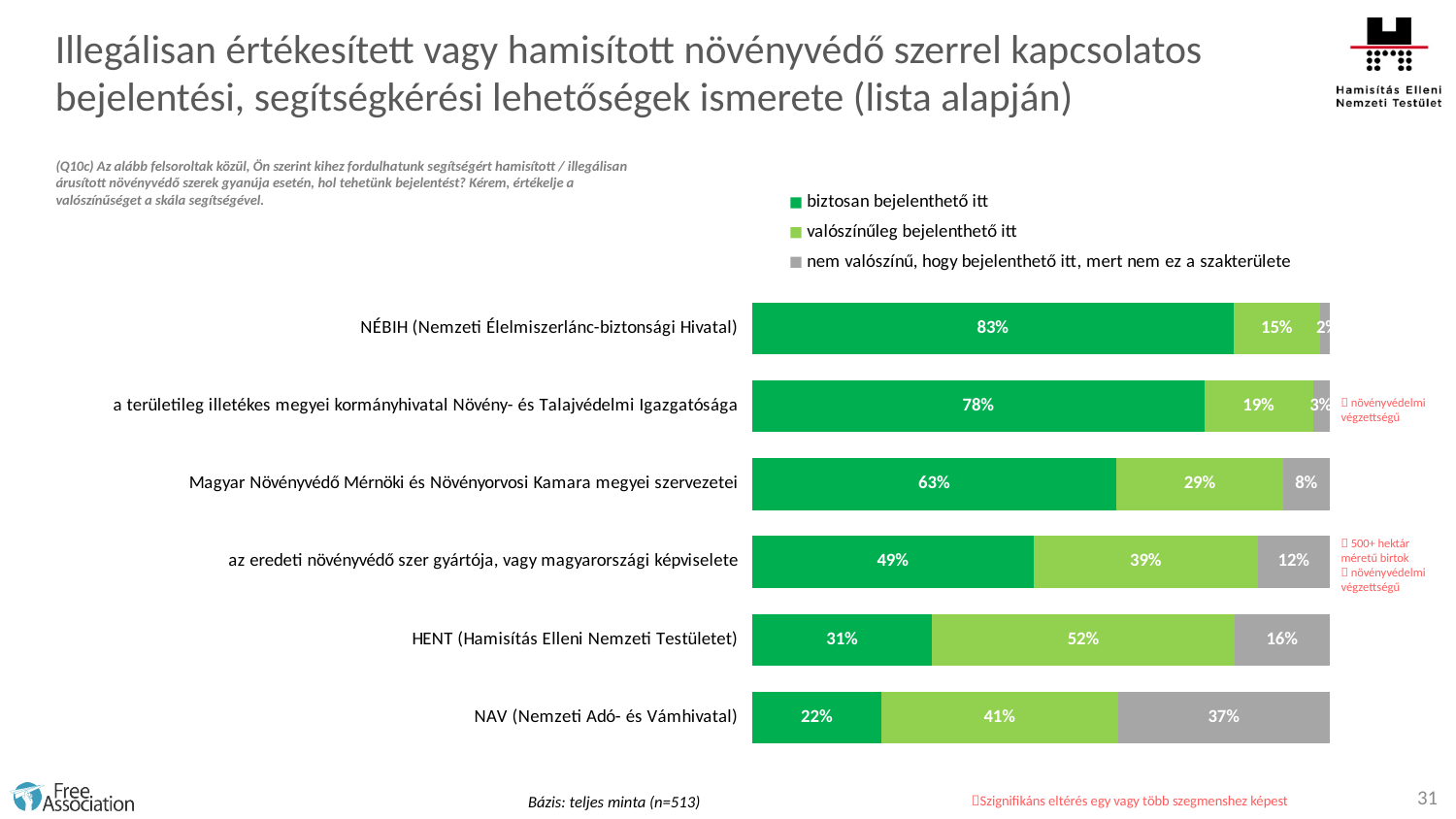
How many categories (organisations) are plotted in the chart? 6 Which is larger: the 'valószínűleg bejelenthető itt' value for the Magyar Növényvédő Mérnöki és Növényorvosi Kamara megyei szervezetei or for az eredeti növényvédő szer gyártója, vagy magyarországi képviselete? az eredeti növényvédő szer gyártója, vagy magyarországi képviselete Which organisation has the highest 'biztosan bejelenthető itt' share? NÉBIH (Nemzeti Élelmiszerlánc-biztonsági Hivatal) Do the 'biztosan bejelenthető itt' values rise or fall going down the list of organisations from top to bottom? fall How many series does the legend list? 3 What is the 'valószínűleg bejelenthető itt' value for HENT (Hamisítás Elleni Nemzeti Testületet)? 52% What is the 'nem valószínű, hogy bejelenthető itt, mert nem ez a szakterülete' value for NAV (Nemzeti Adó- és Vámhivatal)? 37% What is the difference between the 'biztosan bejelenthető itt' values for NÉBIH and HENT? 52 percentage points What is the 'biztosan bejelenthető itt' value for NÉBIH (Nemzeti Élelmiszerlánc-biztonsági Hivatal)? 83% What kind of chart is shown on the slide? stacked bar chart Which organisation has the lowest 'biztosan bejelenthető itt' share? NAV (Nemzeti Adó- és Vámhivatal) Which colour represents the 'biztosan bejelenthető itt' series in the legend? dark green